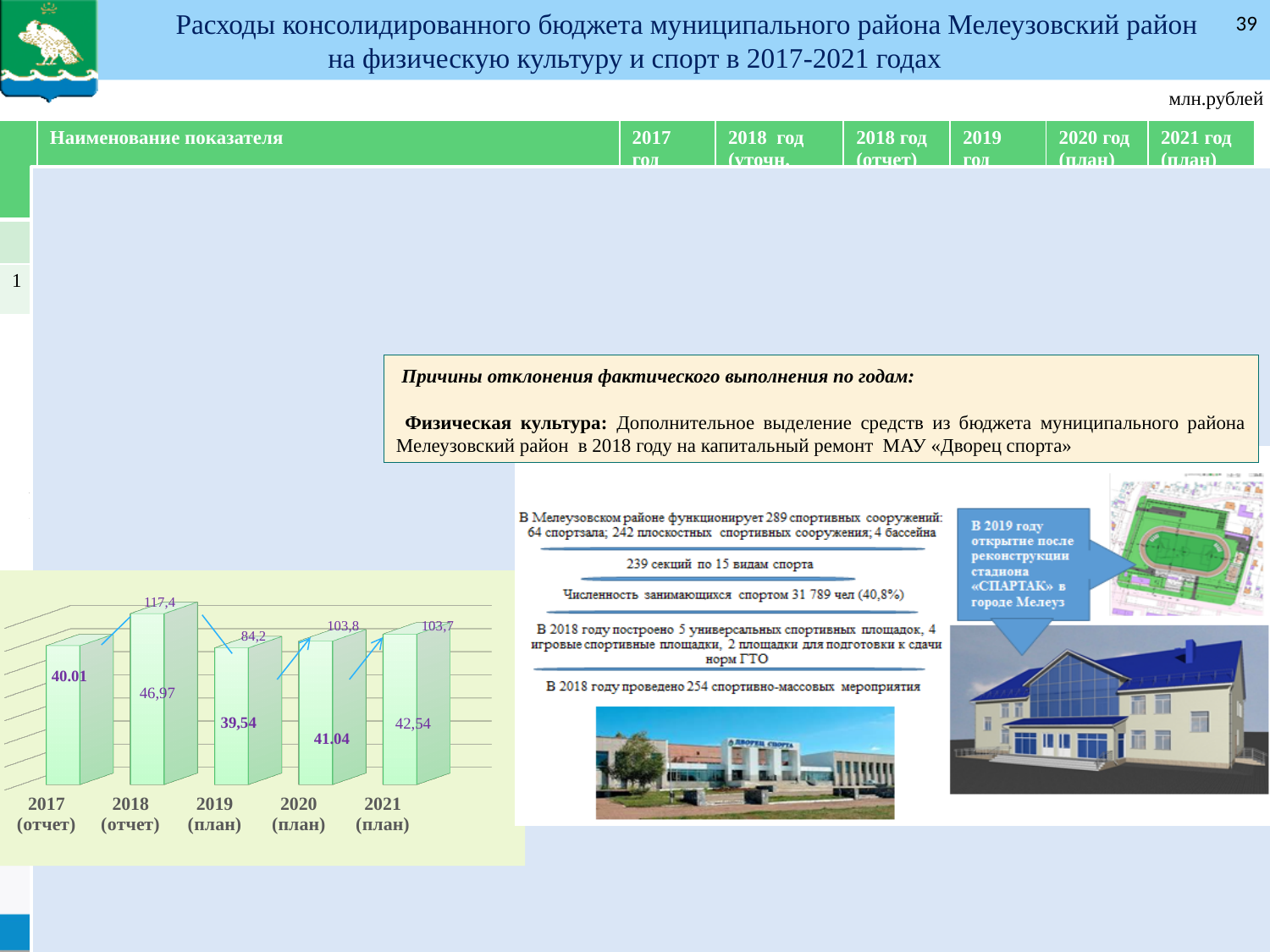
What is the value shown for 2019 (план) in the bar chart? 39,54 What is the value shown for 2021 (план) in the bar chart? 42,54 Which year has the highest bar in the chart? 2018 (отчет) What is the value shown for 2017 (отчет) in the bar chart? 40.01 What is the value shown for 2018 (отчет) in the bar chart? 46,97 What is the value shown for 2020 (план) in the bar chart? 41.04 Which is larger, the value for 2020 (план) or the value for 2021 (план)? 2021 (план) Do the bar values rise or fall from 2019 (план) to 2021 (план)? rise By how much does the 2018 (отчет) value exceed the 2017 (отчет) value? 6,96 What type of chart is shown at the bottom left of the slide? bar chart How many years (categories) are shown in the bar chart? 5 Which year has the lowest bar in the chart? 2019 (план)